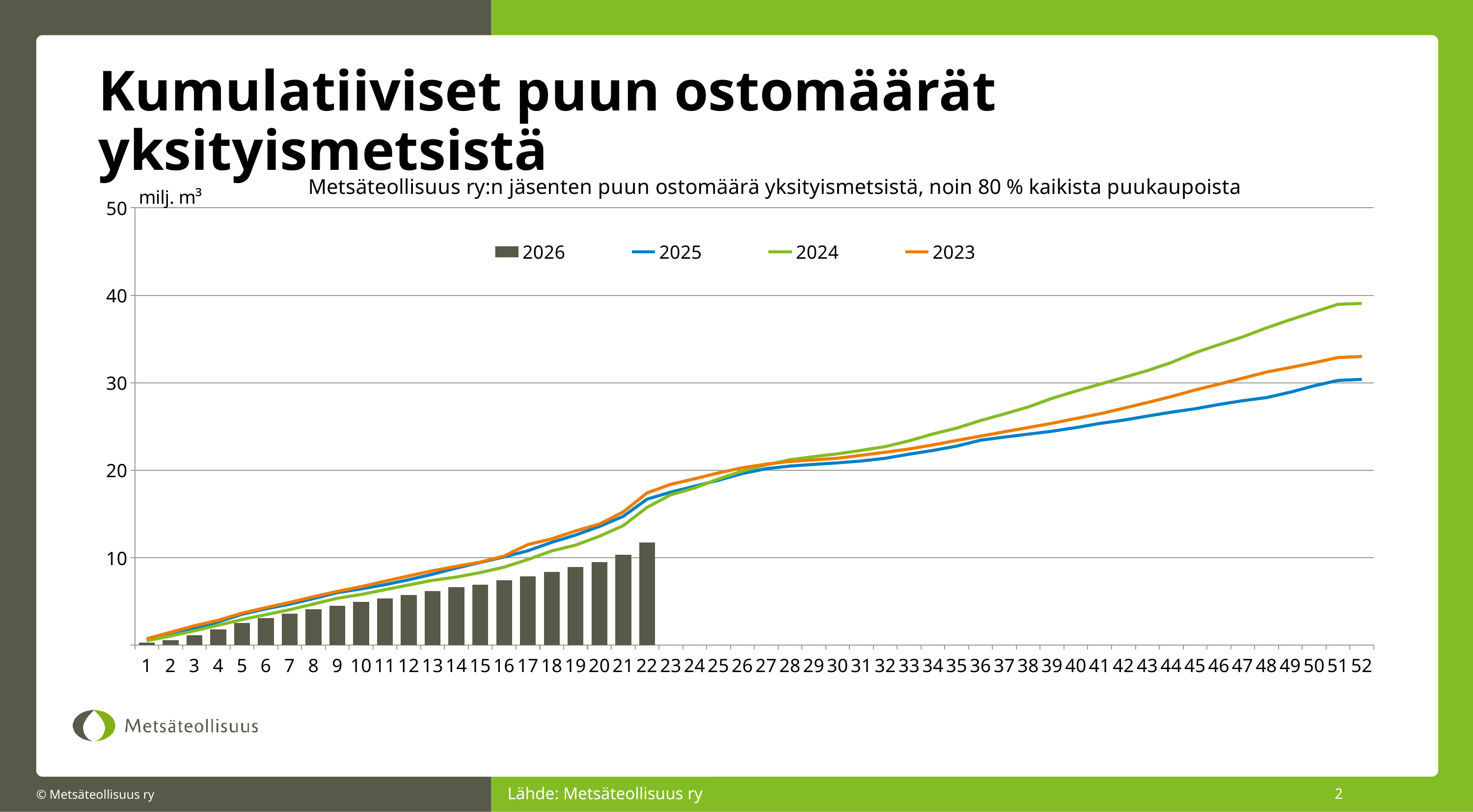
Which series has the highest value at week 52? 2024 Is the value for 2023 at week 52 greater or less than 40? less Is the value for 2026 at week 22 greater or less than 10? greater How many bars are plotted for the 2026 series? 22 How many categories (weeks) are shown on the x axis? 52 Is the value for 2024 at week 52 greater or less than 30? greater What kind of chart is this? Combined bar and line chart How many series does the legend list? 4 What unit is shown on the y axis? milj. m³ Which series has the lowest value at week 52? 2025 Do the values for the 2025 series rise or fall along the x axis? rise